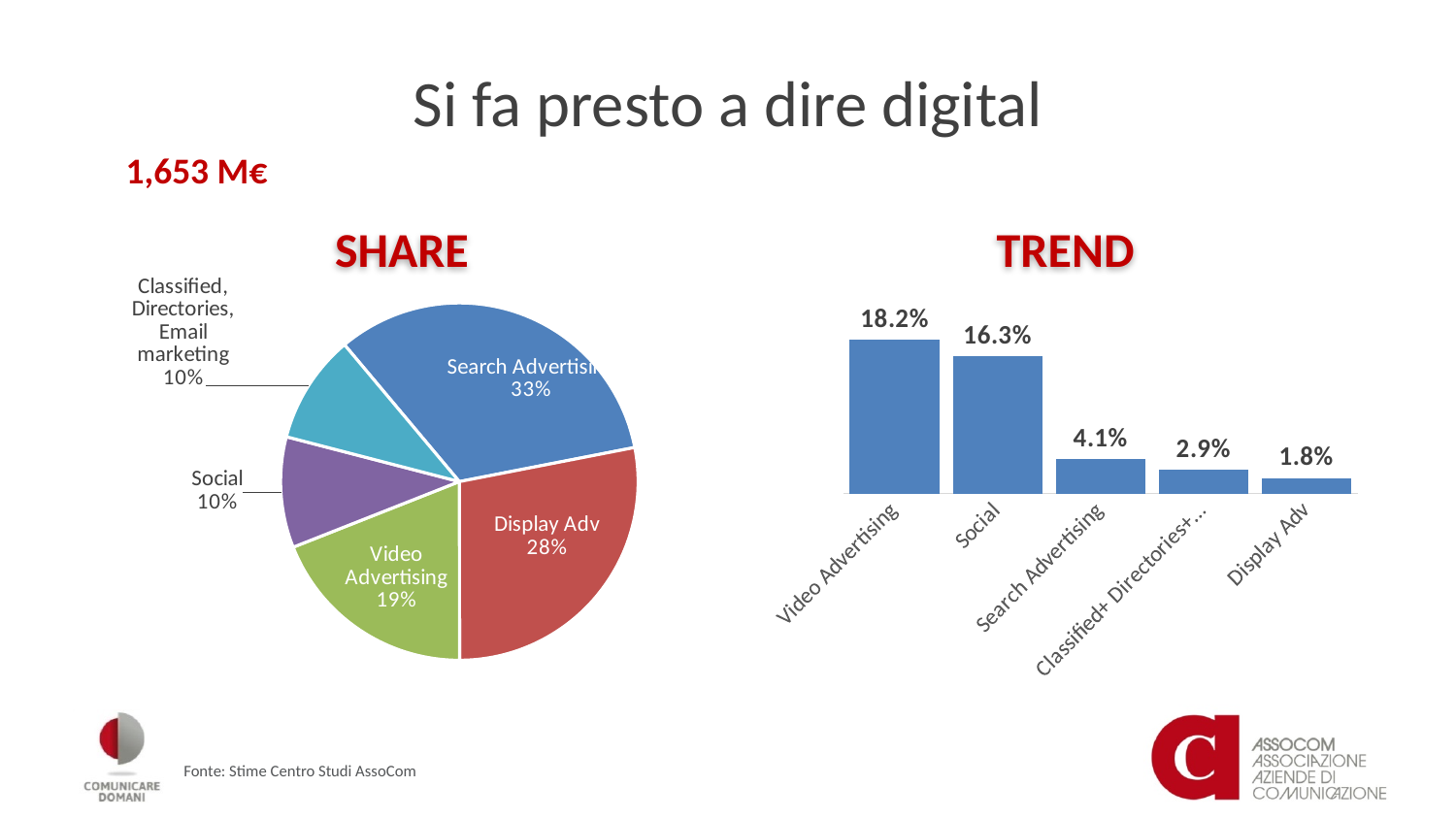
In the SHARE pie chart, what share does Video Advertising have? 19% In the SHARE pie chart, which category has the largest share? Search Advertising In the SHARE pie chart, how many slices are there? 5 In the TREND chart, which category has the lowest value? Display Adv In the TREND chart, do the values rise or fall from left to right? Fall In the TREND chart, what is the value for Social? 16.3% What kind of chart is the TREND chart? Bar chart In the TREND chart, what is the value for Video Advertising? 18.2% In the SHARE pie chart, what is the difference between the Search Advertising share and the Display Adv share? 5% In the SHARE pie chart, what share does Search Advertising have? 33% In the SHARE pie chart, what share does Display Adv have? 28% In the TREND chart, what is the difference between Video Advertising and Social? 1.9%